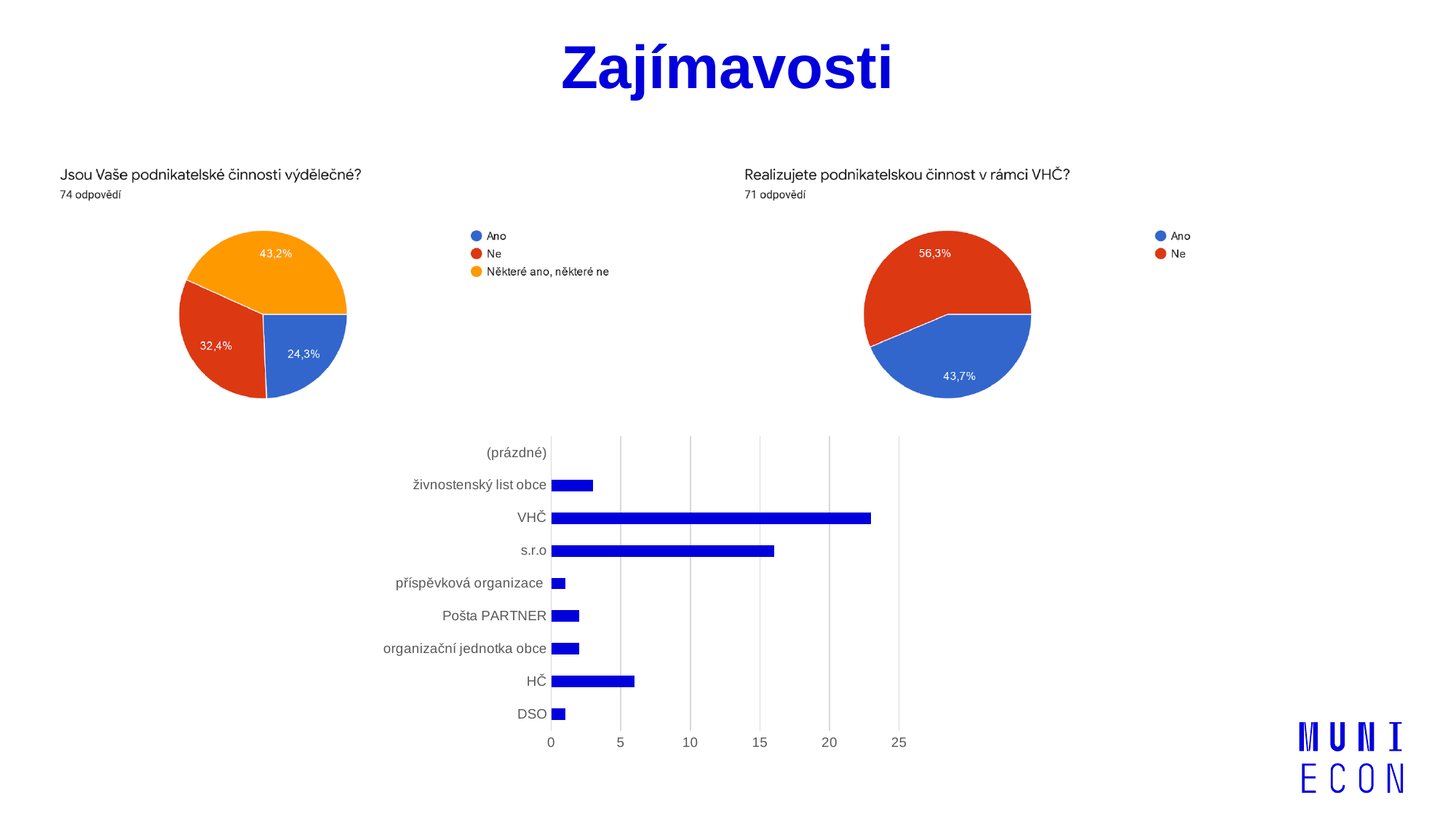
In the bar chart at the bottom of the slide, which is larger, the value for HČ or the value for DSO? HČ In the pie chart titled "Jsou Vaše podnikatelské činnosti výdělečné?", how many entries does the legend list? 3 In the pie chart titled "Realizujete podnikatelskou činnost v rámci VHČ?", what share is labelled for the "Ne" slice? 56,3% In the pie chart titled "Jsou Vaše podnikatelské činnosti výdělečné?", what share is labelled for the "Ne" slice? 32,4% In the bar chart at the bottom of the slide, is the value for s.r.o greater or less than 15? greater In the pie chart titled "Jsou Vaše podnikatelské činnosti výdělečné?", what share is labelled for the "Ano" slice? 24,3% In the pie chart titled "Realizujete podnikatelskou činnost v rámci VHČ?", how many responses are reported under the title? 71 odpovědí In the bar chart at the bottom of the slide, which category has the longest bar? VHČ In the pie chart titled "Realizujete podnikatelskou činnost v rámci VHČ?", what is the difference between the "Ne" and "Ano" shares? 12,6% What kind of chart is shown at the bottom of the slide? bar chart In the pie chart titled "Jsou Vaše podnikatelské činnosti výdělečné?", which category has the largest slice? Některé ano, některé ne In the bar chart at the bottom of the slide, how many categories are listed on the vertical axis? 9